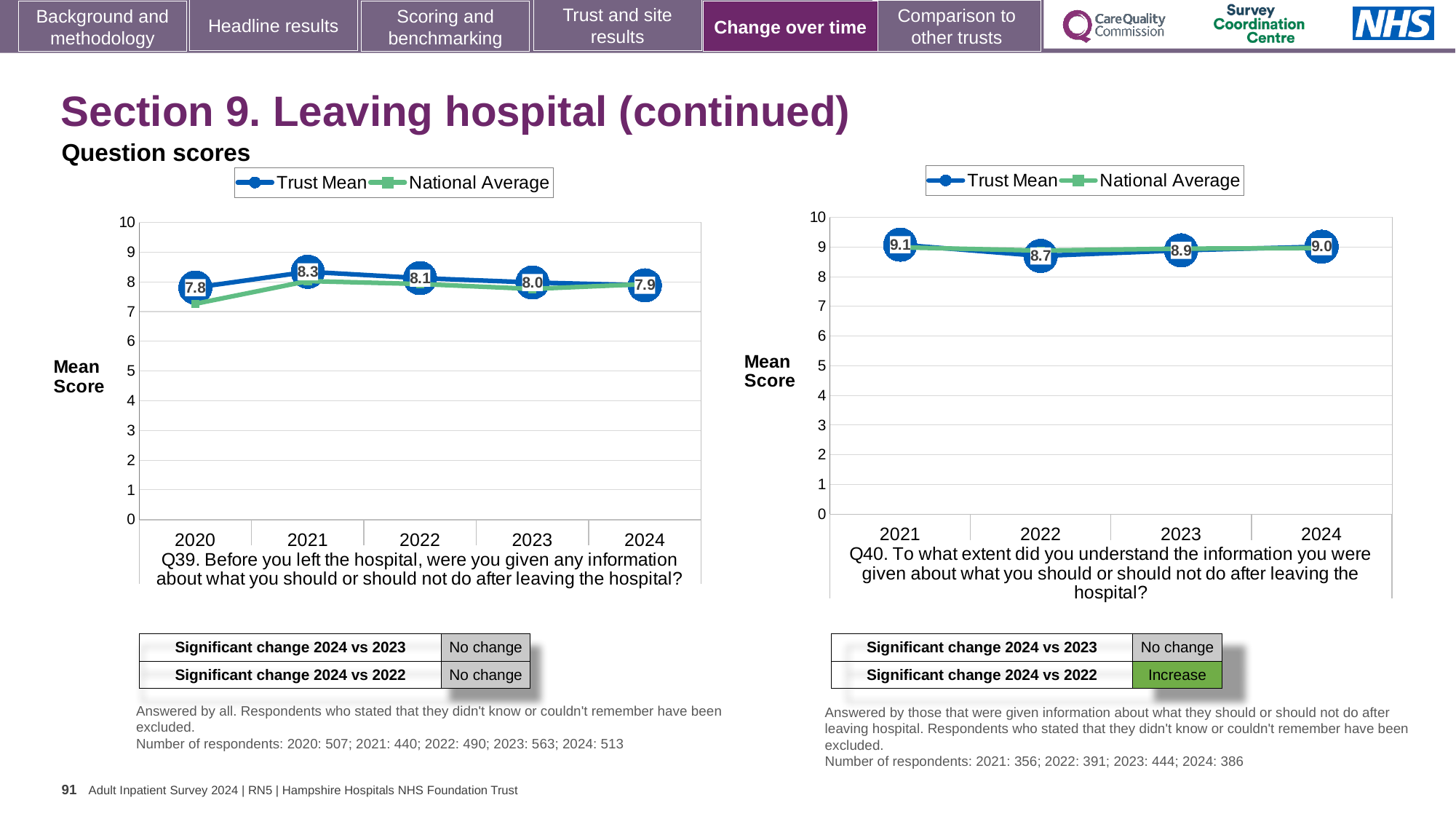
How many series does the legend of the Q40 chart on the right list? 2 What kind of chart is the Q39 chart on the left? Line chart In the Q40 chart on the right, what is the Trust Mean for 2022? 8.7 In the Q39 chart on the left, which year has the highest Trust Mean? 2021 In the Q39 chart on the left, how many years are shown on the x axis? 5 In the Q39 chart on the left, which year has the lowest Trust Mean? 2020 In the Q39 chart on the left, what is the Trust Mean for 2021? 8.3 In the Q40 chart on the right, which year has the highest Trust Mean? 2021 In the Q40 chart on the right, is the National Average for 2021 greater or less than 8? greater In the Q39 chart on the left, what is the Trust Mean for 2024? 7.9 In the Q40 chart on the right, which is larger, the Trust Mean for 2023 or for 2024? 2024 In the Q39 chart on the left, what is the difference between the Trust Mean for 2021 and 2020? 0.5